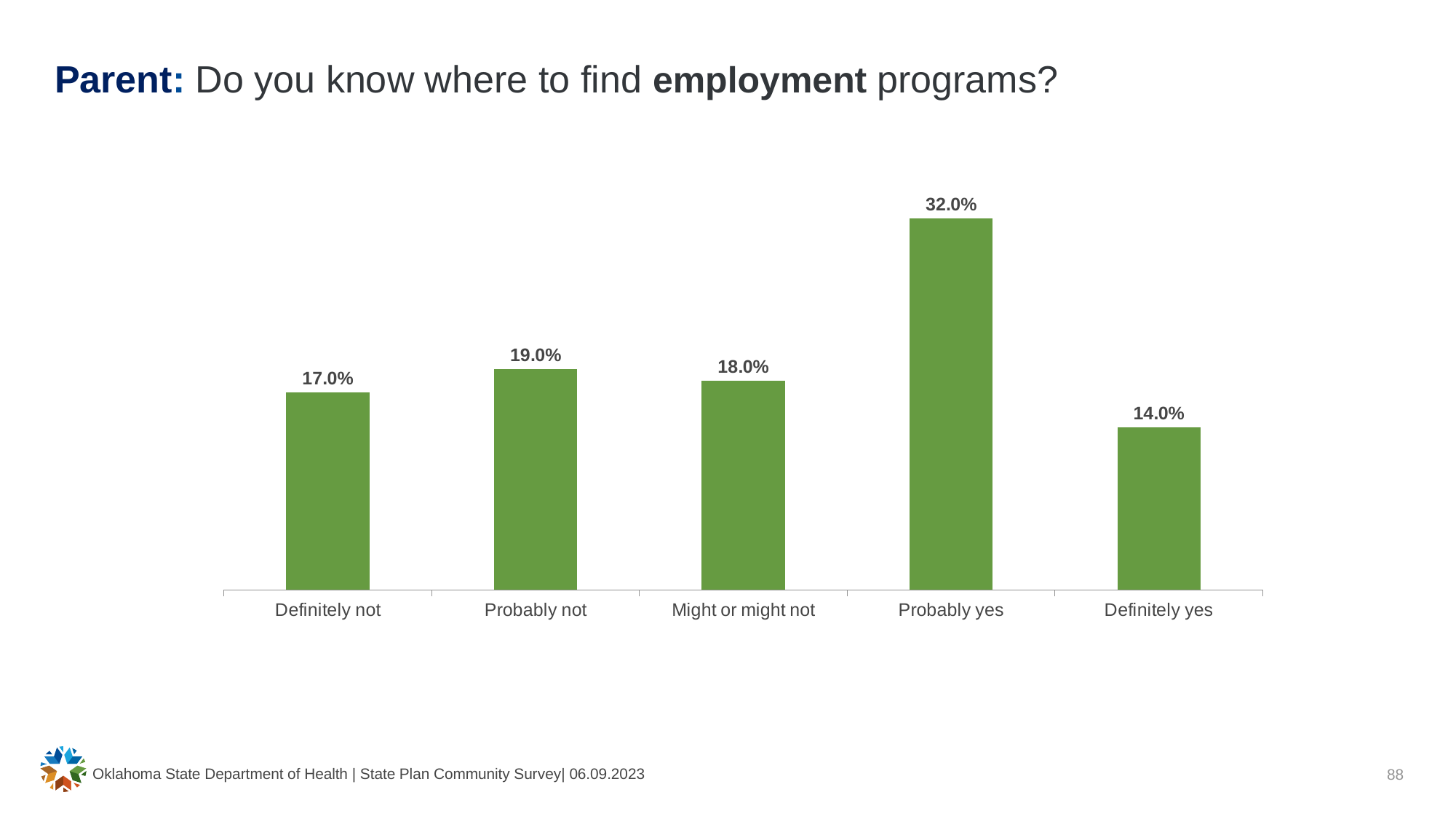
What is the value for "Definitely not"? 17.0% How many categories are shown on the x axis? 5 What is the value for "Definitely yes"? 14.0% Which is larger, the value for "Probably not" or the value for "Might or might not"? Probably not What is the value for "Probably yes"? 32.0% What is the difference between the values for "Probably yes" and "Definitely yes"? 18.0% Which category has the highest value? Probably yes What is the value for "Might or might not"? 18.0% Which category has the lowest value? Definitely yes What kind of chart is shown on the slide? Bar chart What colour are the bars in the chart? Green What is the difference between the values for "Probably not" and "Definitely not"? 2.0%